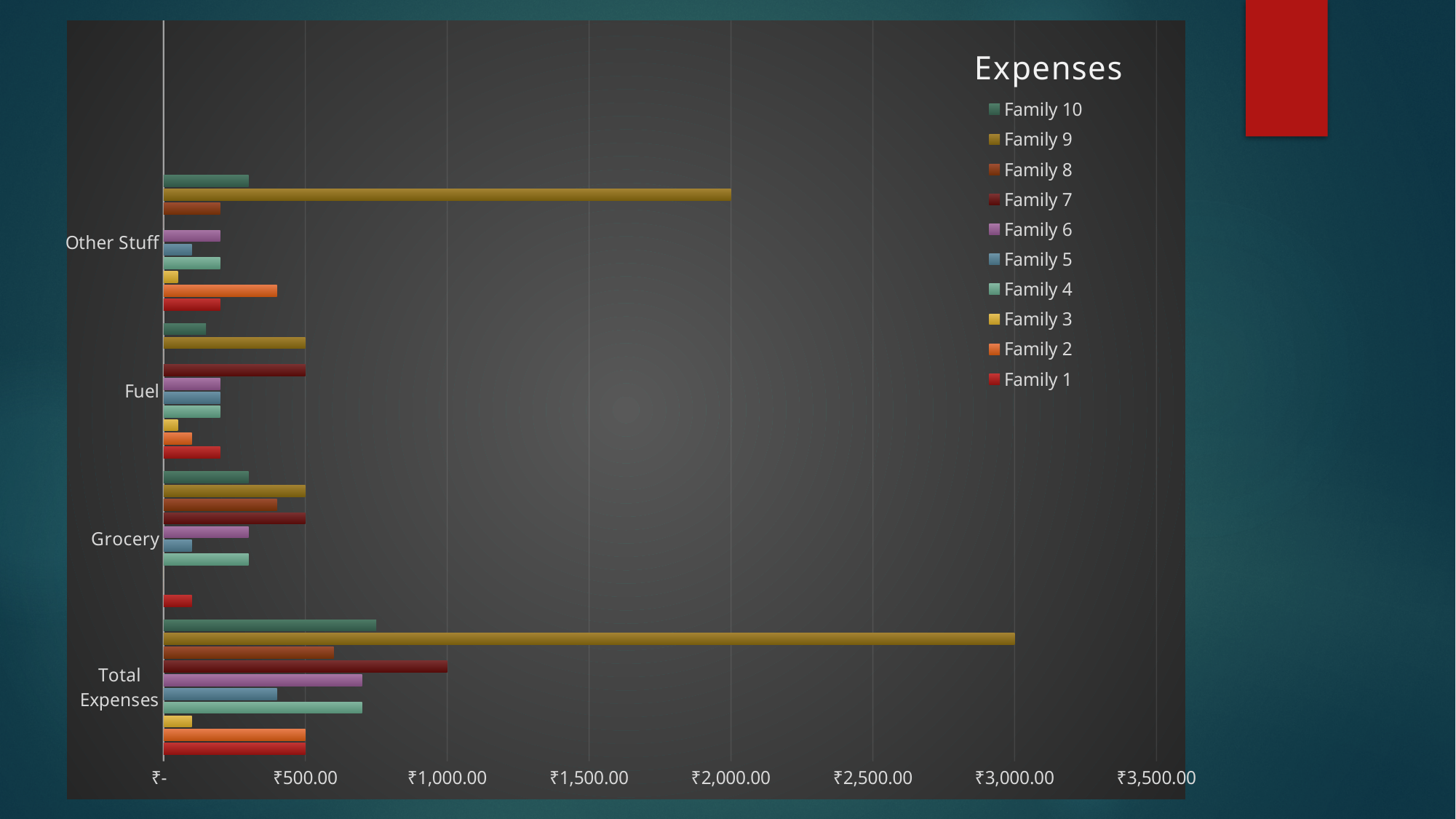
Which family has the highest Total Expenses? Family 9 What is the Other Stuff value for Family 9? ₹2,000.00 How many series does the legend list? 10 What is the Total Expenses value for Family 7? ₹1,000.00 What kind of chart is shown on the slide? bar chart What is the Total Expenses value for Family 9? ₹3,000.00 Which family has the lowest Total Expenses? Family 3 Which is larger, the Total Expenses for Family 7 or for Family 8? Family 7 How many categories are shown on the vertical axis? 4 What is the difference between Family 9's Total Expenses and Family 7's Total Expenses? ₹2,000.00 What is the title of the chart? Expenses Is the Total Expenses value for Family 10 greater or less than ₹500.00? greater